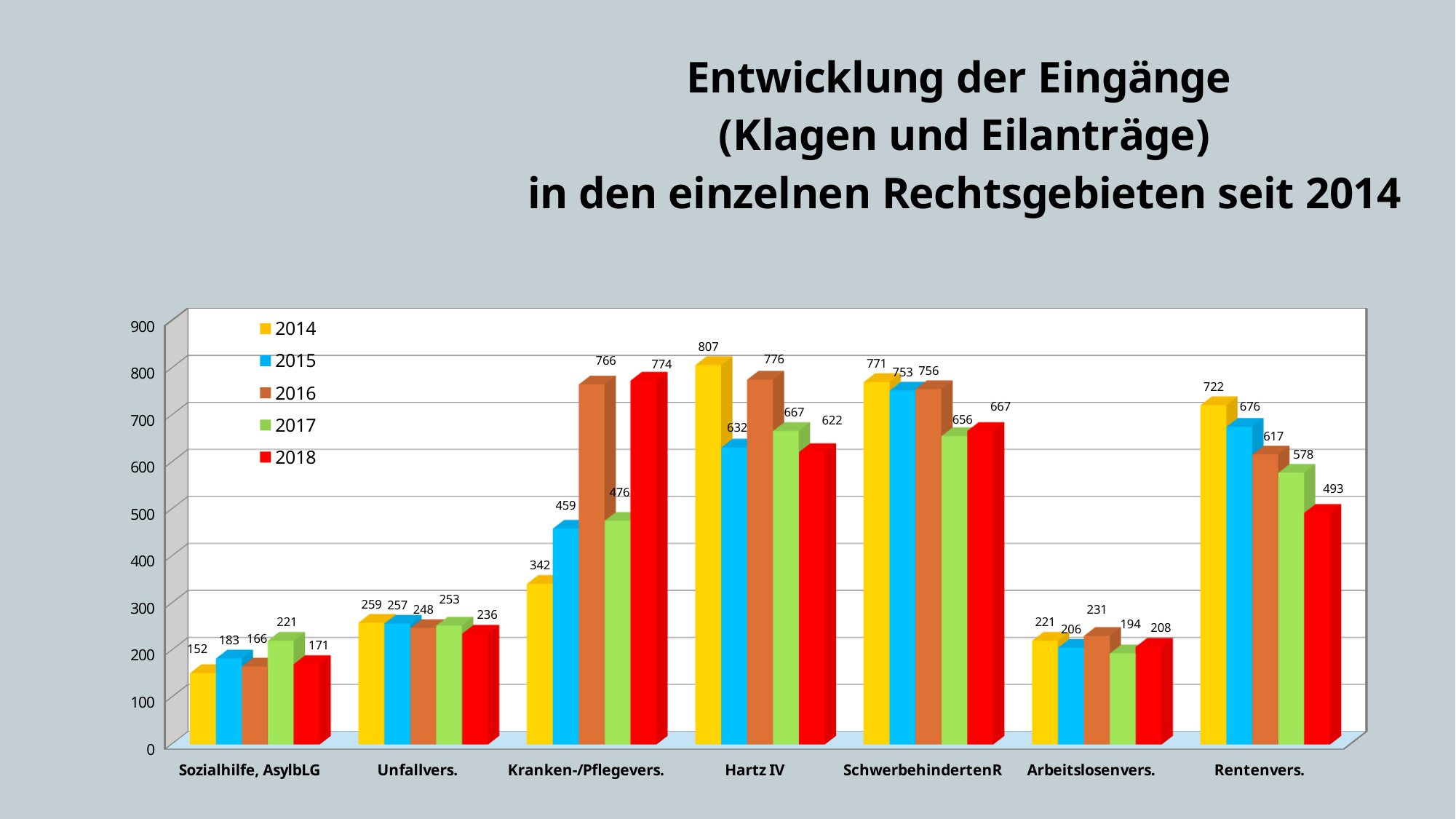
What kind of chart is shown on the slide? bar chart Which colour represents the 2018 series in the legend? red Which category has the highest value in the 2014 series? Hartz IV Do the values for Rentenvers. rise or fall from 2014 to 2018? fall Which is larger for Kranken-/Pflegevers.: the 2015 value or the 2017 value? 2017 What is the difference between the 2014 and 2018 values for Rentenvers.? 229 How many categories are shown on the x axis? 7 What is the value for Hartz IV in 2014? 807 How many series does the legend list? 5 What is the value for Rentenvers. in 2018? 493 What is the value for Kranken-/Pflegevers. in 2016? 766 Which category has the lowest value in the 2017 series? Arbeitslosenvers.